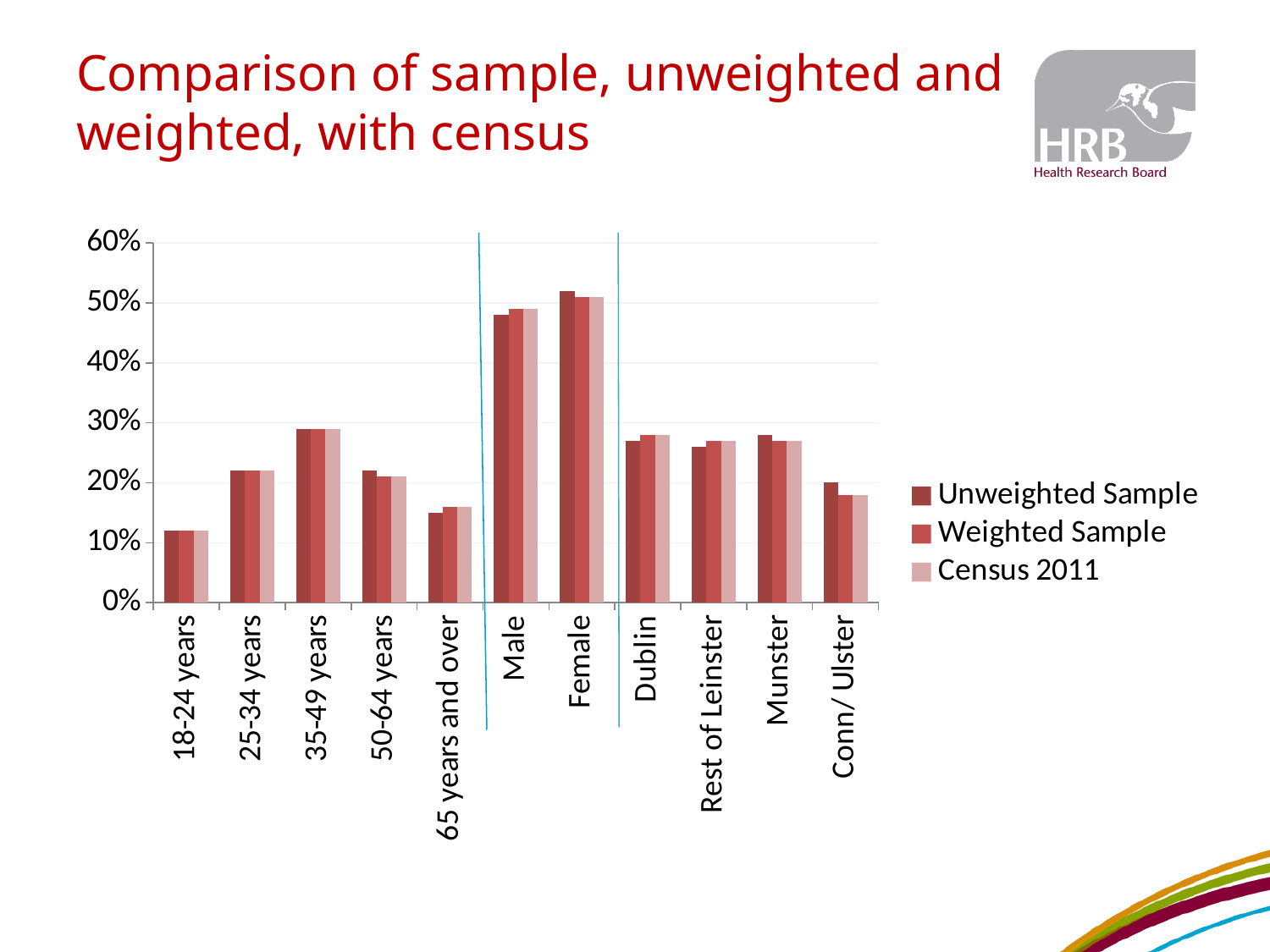
Is the Census 2011 value for 65 years and over greater or less than 20%? less How many series does the legend list? 3 What kind of chart is shown on the slide? bar chart Which category has the lowest value in the chart? 18-24 years Which category has the highest value in the chart? Female What is the name of the third series listed in the legend? Census 2011 How many categories are shown along the x axis? 11 Is the Unweighted Sample value for Female greater or less than 50%? greater Which is larger in the Census 2011 series, 25-34 years or 35-49 years? 35-49 years Which is larger in the Unweighted Sample series, Male or Female? Female Is the Census 2011 value for 35-49 years greater or less than 30%? less